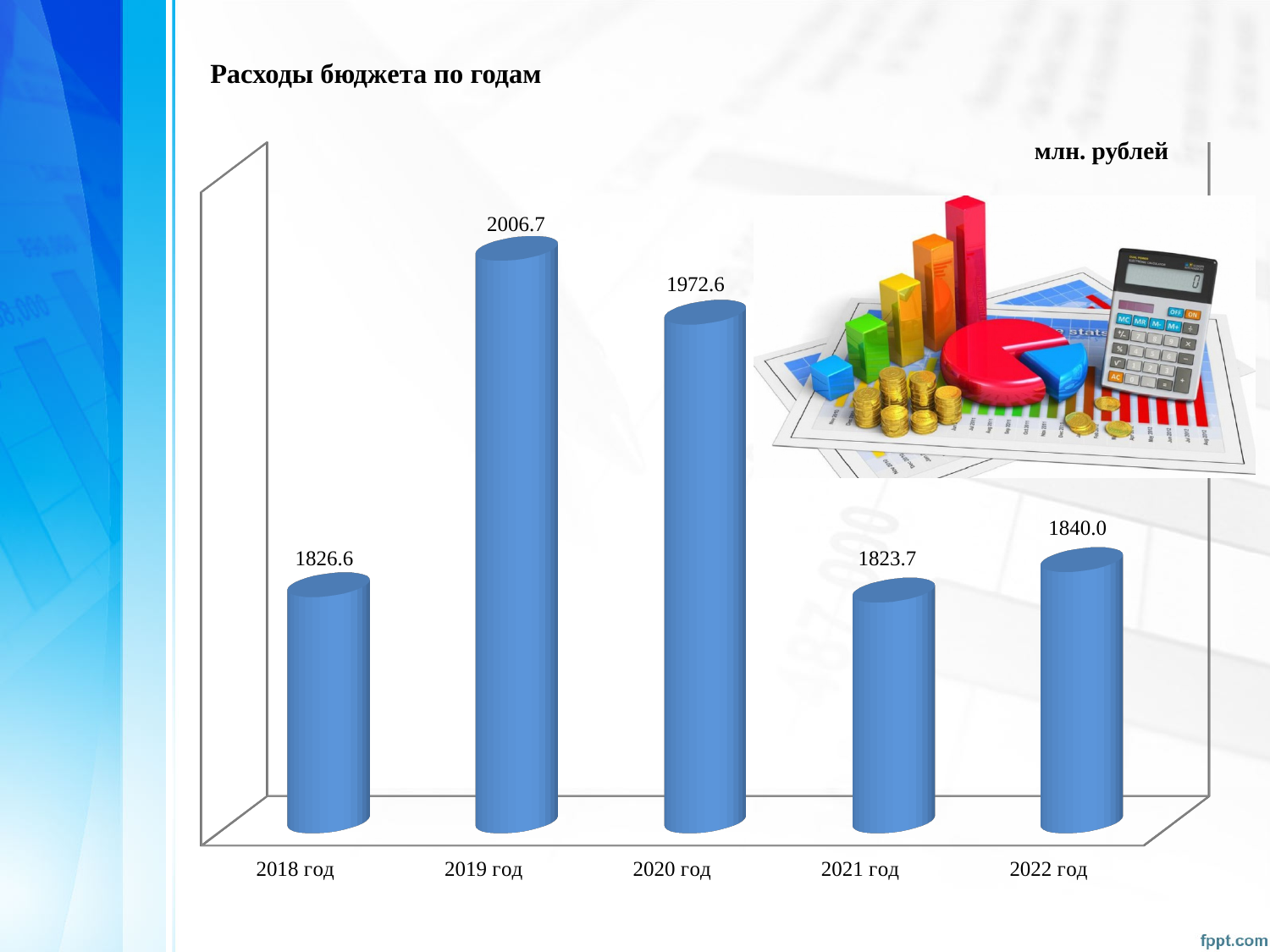
Which year has the lowest budget expenditure? 2021 год How many years are shown on the chart? 5 What is the value shown for 2021 год? 1823.7 What is the title of the chart? Расходы бюджета по годам What is the difference between the values for 2019 год and 2020 год? 34.1 In what units are the values on the chart expressed? млн. рублей What type of chart is shown on the slide? Bar chart What is the budget expenditure value for 2019 год? 2006.7 Which year has the highest budget expenditure? 2019 год What is the difference between the values for 2022 год and 2021 год? 16.3 Which is larger, the value for 2018 год or the value for 2021 год? 2018 год What is the value shown for 2022 год? 1840.0